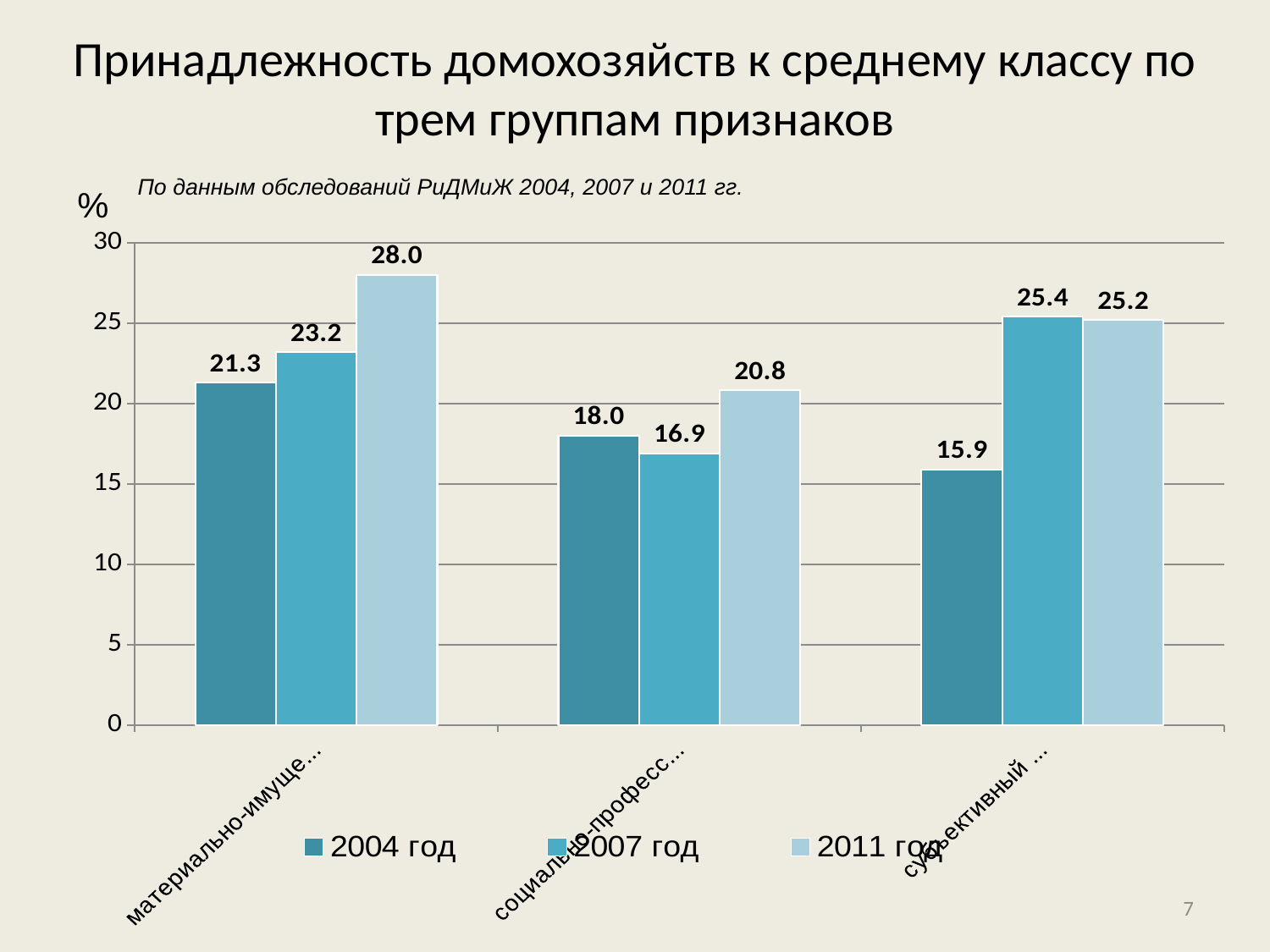
Which year has the lowest value in the third category group (субъективный ...)? 2004 год Is the value for 2011 год in the second category group (социально-офесс...) greater or less than 20? greater What is the value for 2011 год in the first category group (материально-имуще...)? 28.0 Which year has the highest value in the first category group (материально-имуще...)? 2011 год How many category groups are shown on the x axis? 3 In the second category group (социально-офесс...), which is larger: the 2004 год value or the 2007 год value? 2004 год What is the value for 2007 год in the second category group (социально-професс...)? 16.9 What kind of chart is shown on the slide? bar chart What unit is shown on the vertical axis of the chart? % How many series does the legend list? 3 What is the value for 2004 год in the third category group (субъективный ...)? 15.9 What is the difference between the 2011 год and 2004 год values in the first category group (материально-имуще...)? 6.7